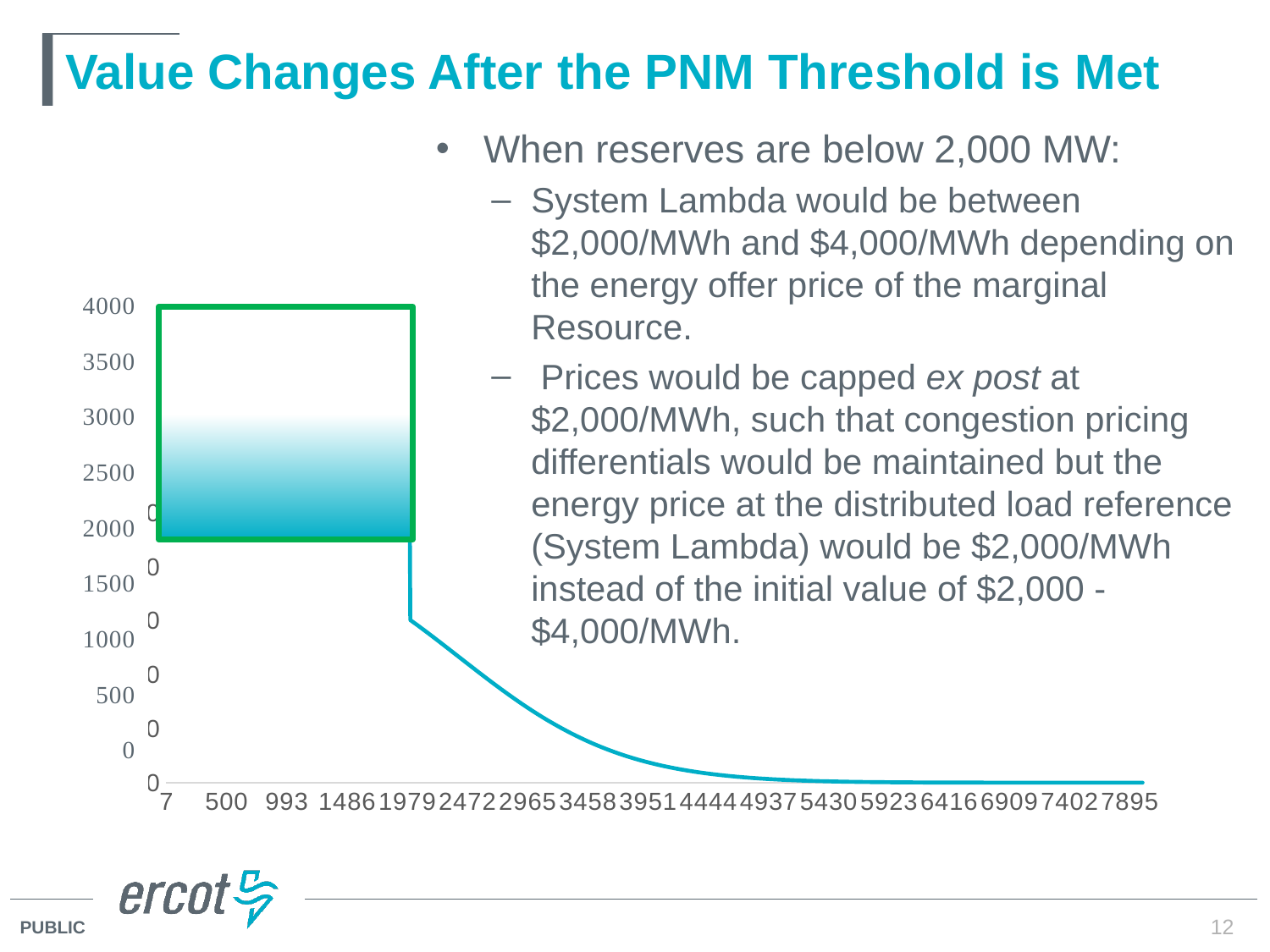
Is the plotted value at x = 5430 greater or less than 500? less Do the plotted values rise or fall as you move from left to right along the x axis? fall What kind of chart is shown on the slide? line chart What is the highest value labelled on the y axis? 4000 Is the plotted value at x = 2965 greater or less than 1000? less Is the plotted value at x = 3951 greater or less than 500? less How many tick labels are shown along the x axis? 17 What is the first (leftmost) tick label on the x axis? 7